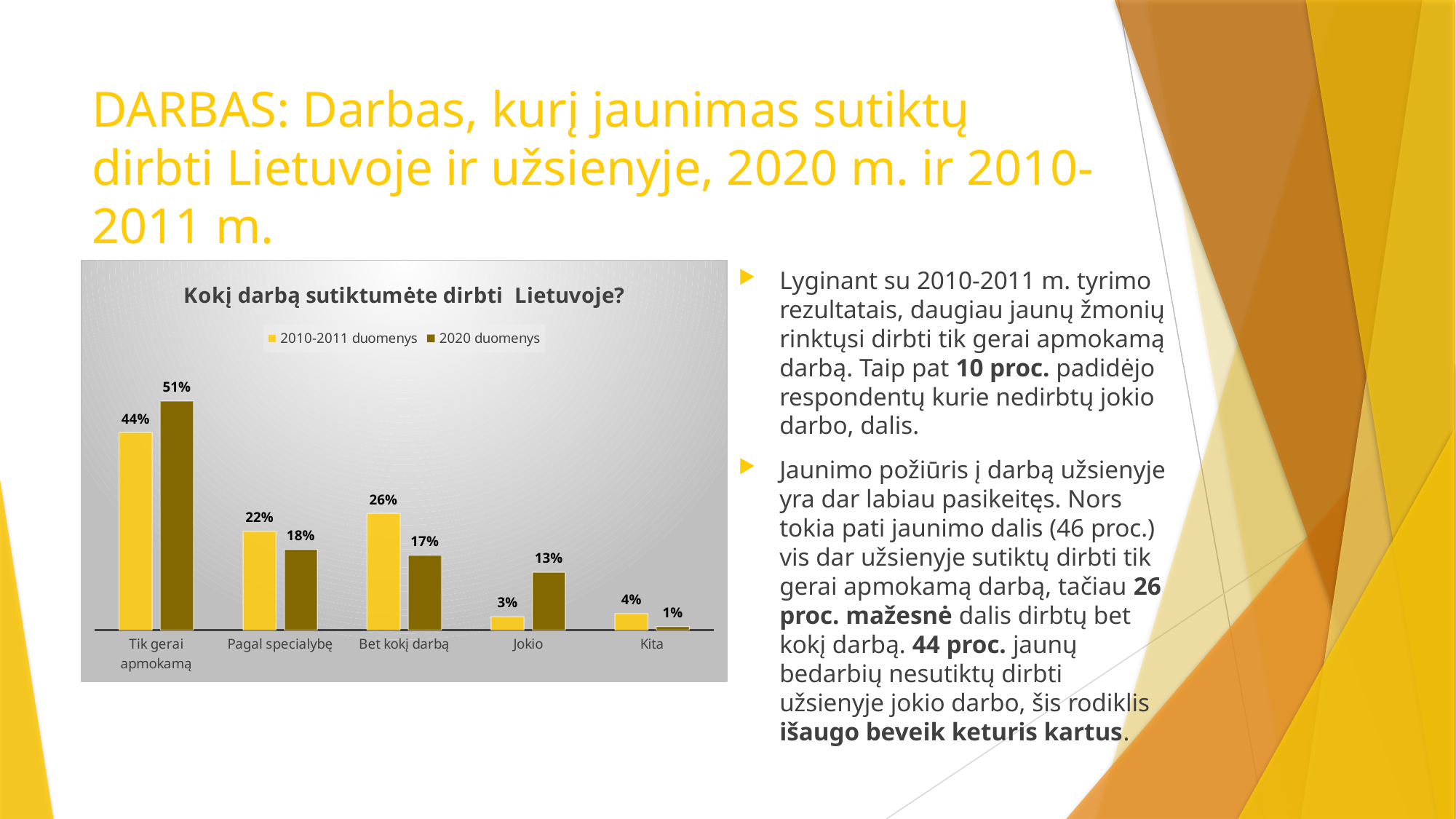
What is the value for 'Bet kokį darbą' in the 2010-2011 duomenys series? 26% What kind of chart is shown on the slide? Bar chart What is the value for 'Tik gerai apmokamą' in the 2020 duomenys series? 51% Which category has the highest value in the 2010-2011 duomenys series? Tik gerai apmokamą What is the difference between the 2020 duomenys and 2010-2011 duomenys values for 'Jokio'? 10% How many series does the chart legend list? 2 What is the difference between the 2010-2011 duomenys and 2020 duomenys values for 'Bet kokį darbą'? 9% Which category has the lowest value in the 2020 duomenys series? Kita Which is larger for 'Pagal specialybę': the 2010-2011 duomenys value or the 2020 duomenys value? 2010-2011 duomenys What is the title of the chart? Kokį darbą sutiktumėte dirbti Lietuvoje? What is the value for 'Jokio' in the 2020 duomenys series? 13% How many categories are shown on the x axis of the chart? 5